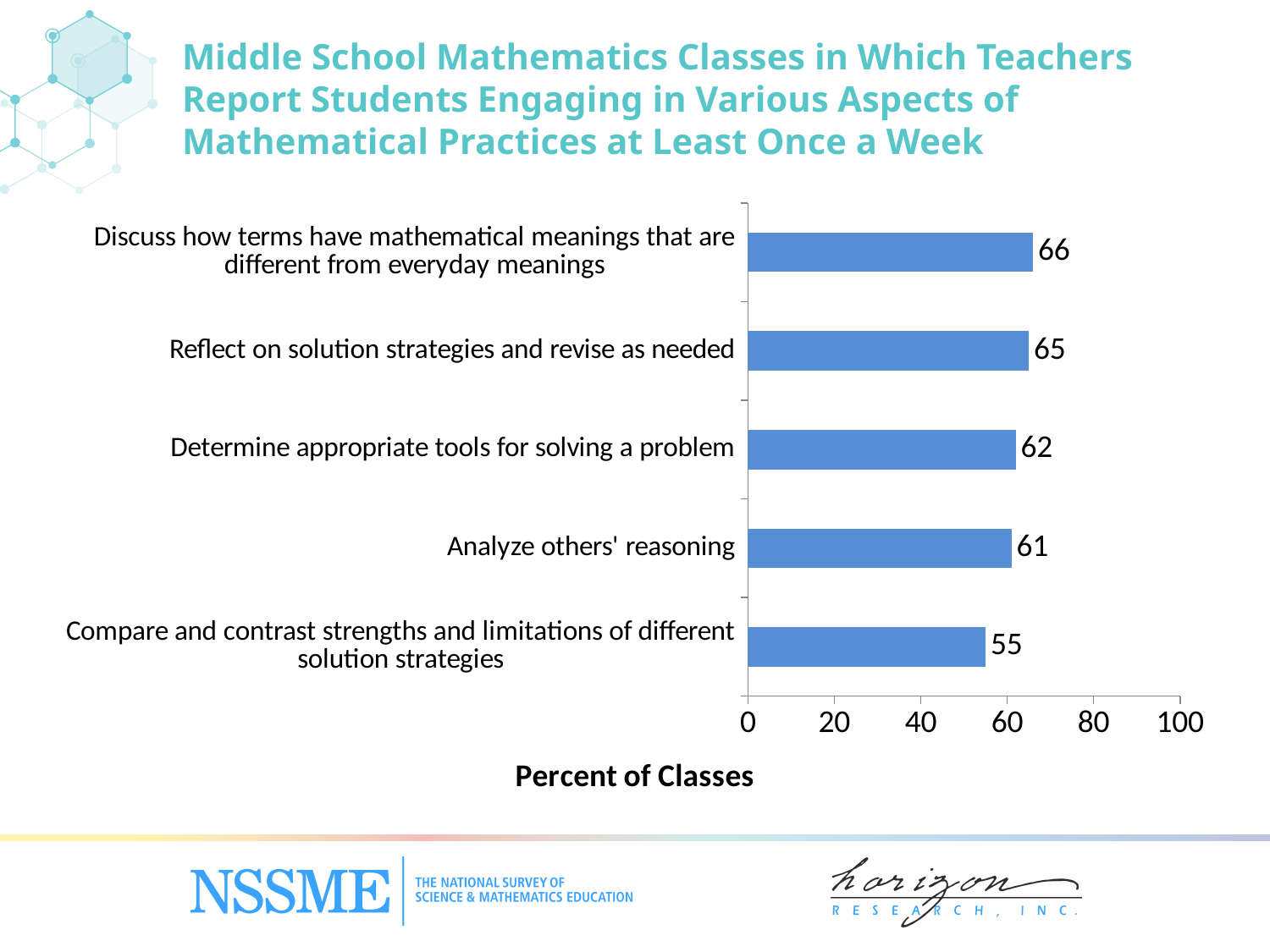
Which category has the highest percent of classes? Discuss how terms have mathematical meanings that are different from everyday meanings What percent of classes is reported for "Analyze others' reasoning"? 61 What kind of chart is shown on the slide? bar chart Is the value for "Reflect on solution strategies and revise as needed" greater or less than 60? greater What is the value for "Determine appropriate tools for solving a problem"? 62 What is the difference between the values for "Discuss how terms have mathematical meanings that are different from everyday meanings" and "Compare and contrast strengths and limitations of different solution strategies"? 11 What is the value for "Compare and contrast strengths and limitations of different solution strategies"? 55 Which category has the lowest percent of classes? Compare and contrast strengths and limitations of different solution strategies What is the label of the horizontal axis? Percent of Classes What is the difference between the values for "Reflect on solution strategies and revise as needed" and "Analyze others' reasoning"? 4 How many categories are shown in the chart? 5 Which is larger: the value for "Determine appropriate tools for solving a problem" or the value for "Compare and contrast strengths and limitations of different solution strategies"? Determine appropriate tools for solving a problem